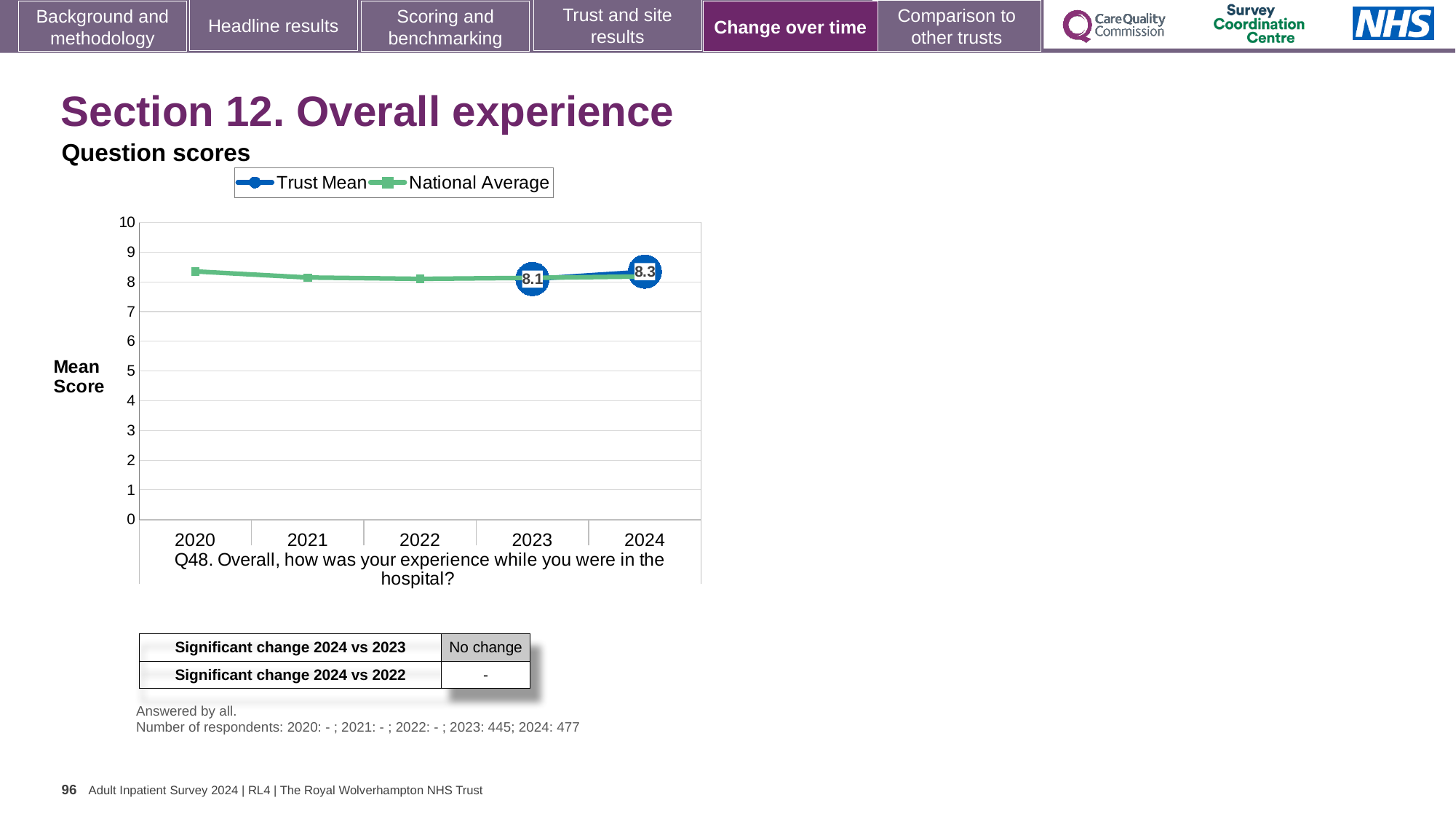
What is the Trust Mean value for 2024? 8.3 What is the difference between the Trust Mean in 2024 and in 2023? 0.2 What kind of chart is shown on the slide? line chart Is the National Average value for 2021 greater or less than 9? less How many years are shown on the x axis? 5 Does the Trust Mean rise or fall from 2023 to 2024? rise How many series does the legend list? 2 In which year is the Trust Mean highest? 2024 Is the National Average value for 2020 greater or less than 8? greater What is the Trust Mean value for 2023? 8.1 Which year has the higher Trust Mean, 2023 or 2024? 2024 What is the label on the y axis of the chart? Mean Score